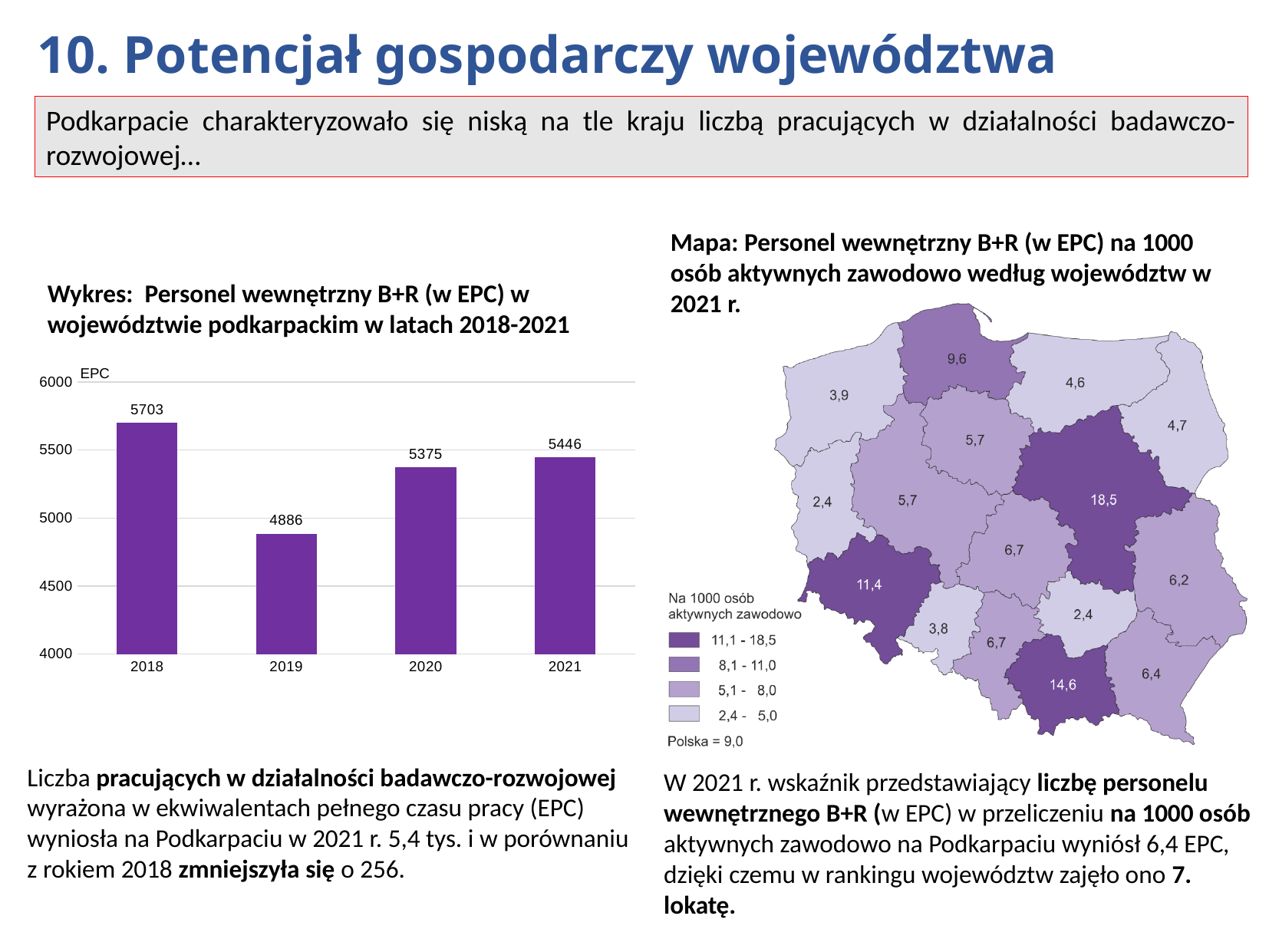
What kind of chart is the chart on the left of the slide? bar chart In the bar chart on the left, what is the difference between the values for 2018 and 2021? 257 In the bar chart on the left, which year has the lowest value? 2019 In the bar chart on the left, is the value for 2019 greater or less than 5000? less How many years (bars) are shown in the bar chart on the left? 4 In the bar chart on the left, what is the value for 2019? 4886 In the bar chart on the left, which year has the highest value? 2018 In the bar chart on the left, what is the difference between the values for 2020 and 2019? 489 In the bar chart on the left, what is the value for 2021? 5446 In the bar chart on the left, what unit label is shown at the top of the vertical axis? EPC In the bar chart on the left, which is larger: the value for 2020 or the value for 2021? 2021 In the bar chart 'Personel wewnętrzny B+R (w EPC) w województwie podkarpackim w latach 2018-2021', what is the value for 2018? 5703